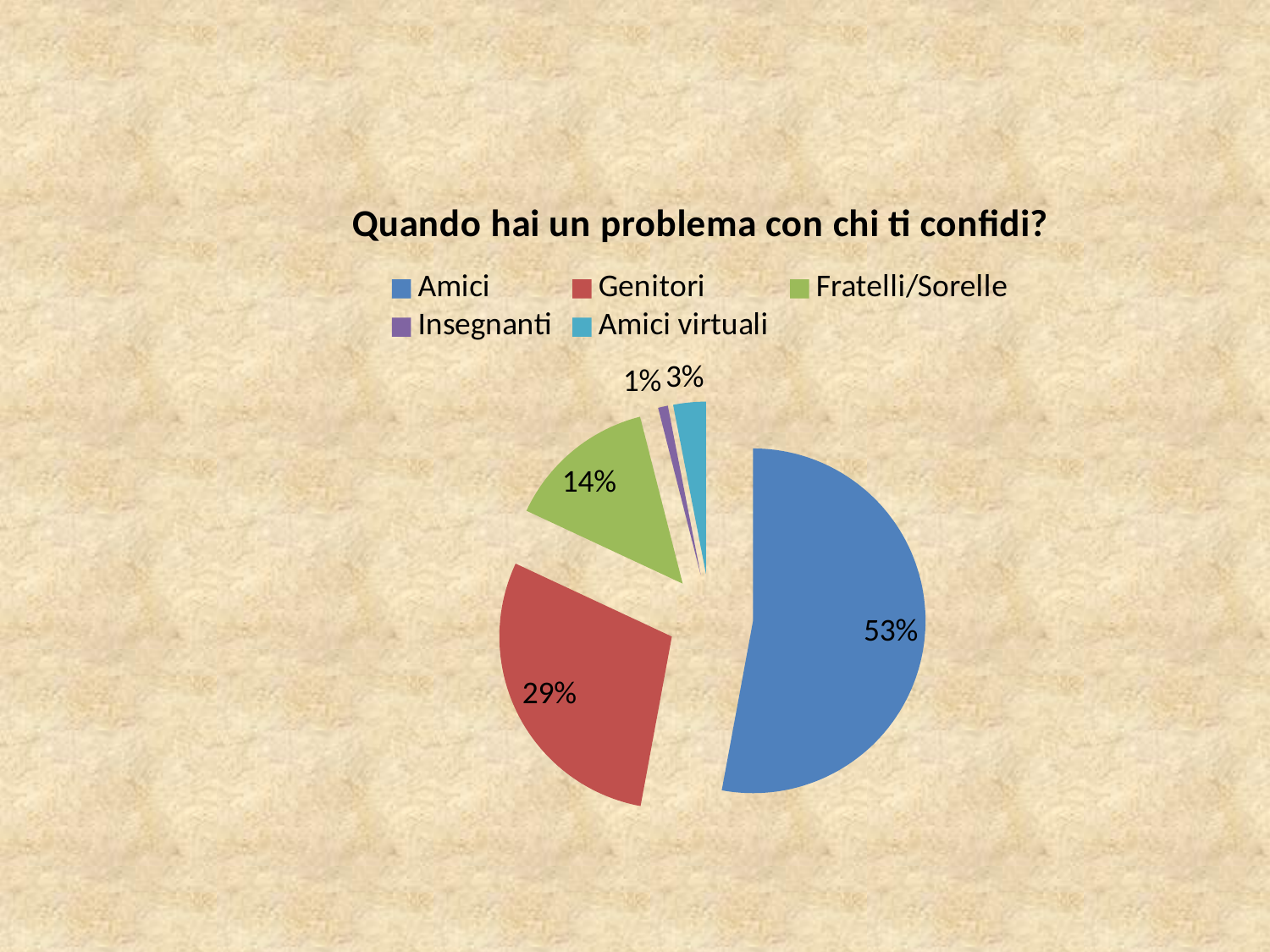
Which is larger, Fratelli/Sorelle or Amici virtuali? Fratelli/Sorelle What share of the pie is Amici? 53% How many categories does the legend list? 5 What share of the pie is Amici virtuali? 3% What share of the pie is Fratelli/Sorelle? 14% Which category has the largest slice? Amici What is the title of the chart? Quando hai un problema con chi ti confidi? What is the difference in percentage points between Amici and Genitori? 24 Which category has the smallest slice? Insegnanti What kind of chart is shown on the slide? Pie chart